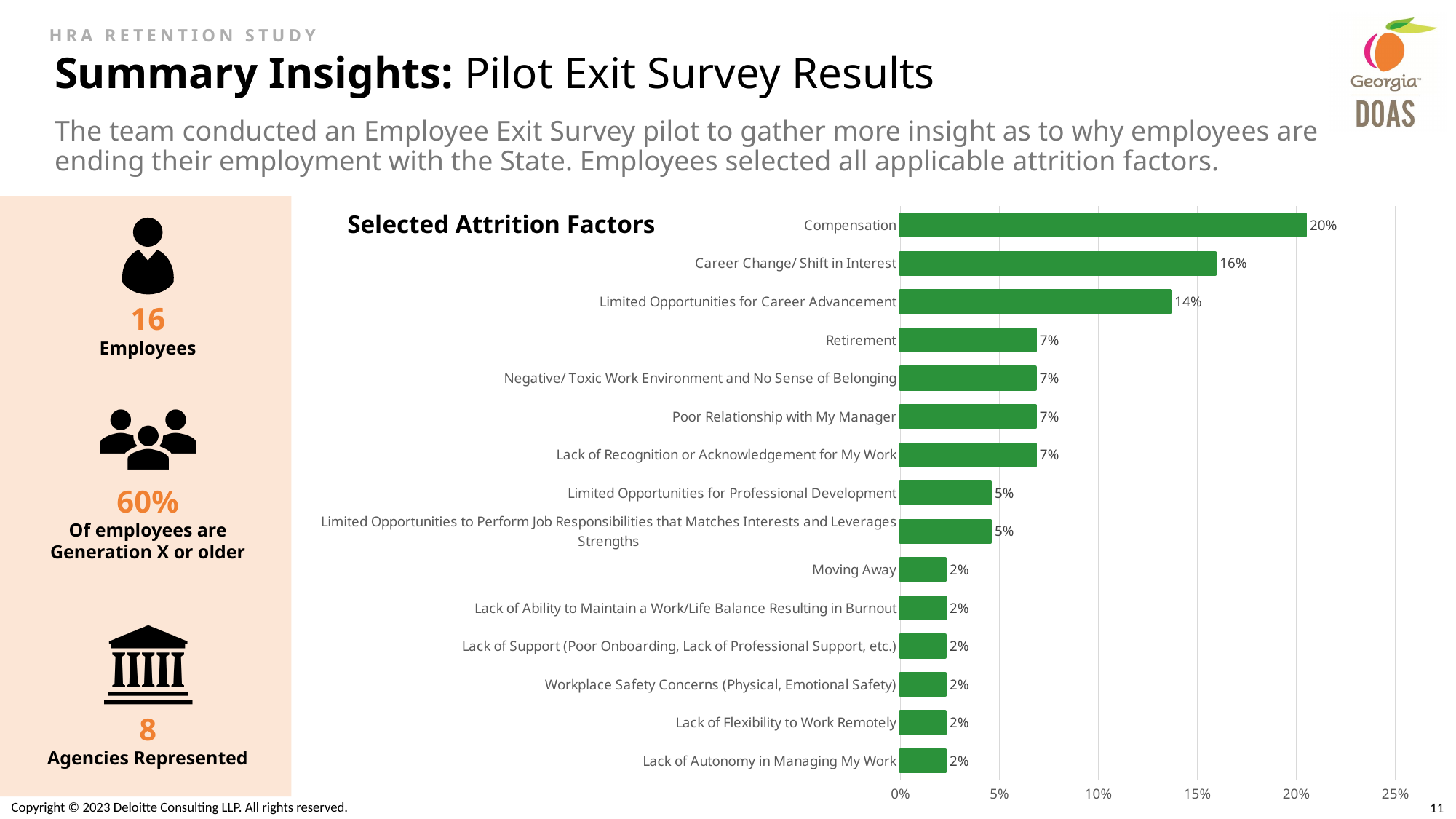
What is the title of the chart on the slide? Selected Attrition Factors What is the difference between the values for Compensation and Career Change/ Shift in Interest? 4% What percentage of employees selected Compensation as an attrition factor? 20% What is the difference between the values for Limited Opportunities for Career Advancement and Retirement? 7% What is the value shown for Moving Away? 2% Which is larger, the value for Poor Relationship with My Manager or the value for Limited Opportunities for Professional Development? Poor Relationship with My Manager What is the value shown for Career Change/ Shift in Interest? 16% What is the value shown for Retirement? 7% What kind of chart is used to show the Selected Attrition Factors? Bar chart How many attrition factors are plotted in the chart? 15 Which attrition factor has the highest value in the chart? Compensation What is the value shown for Limited Opportunities for Career Advancement? 14%